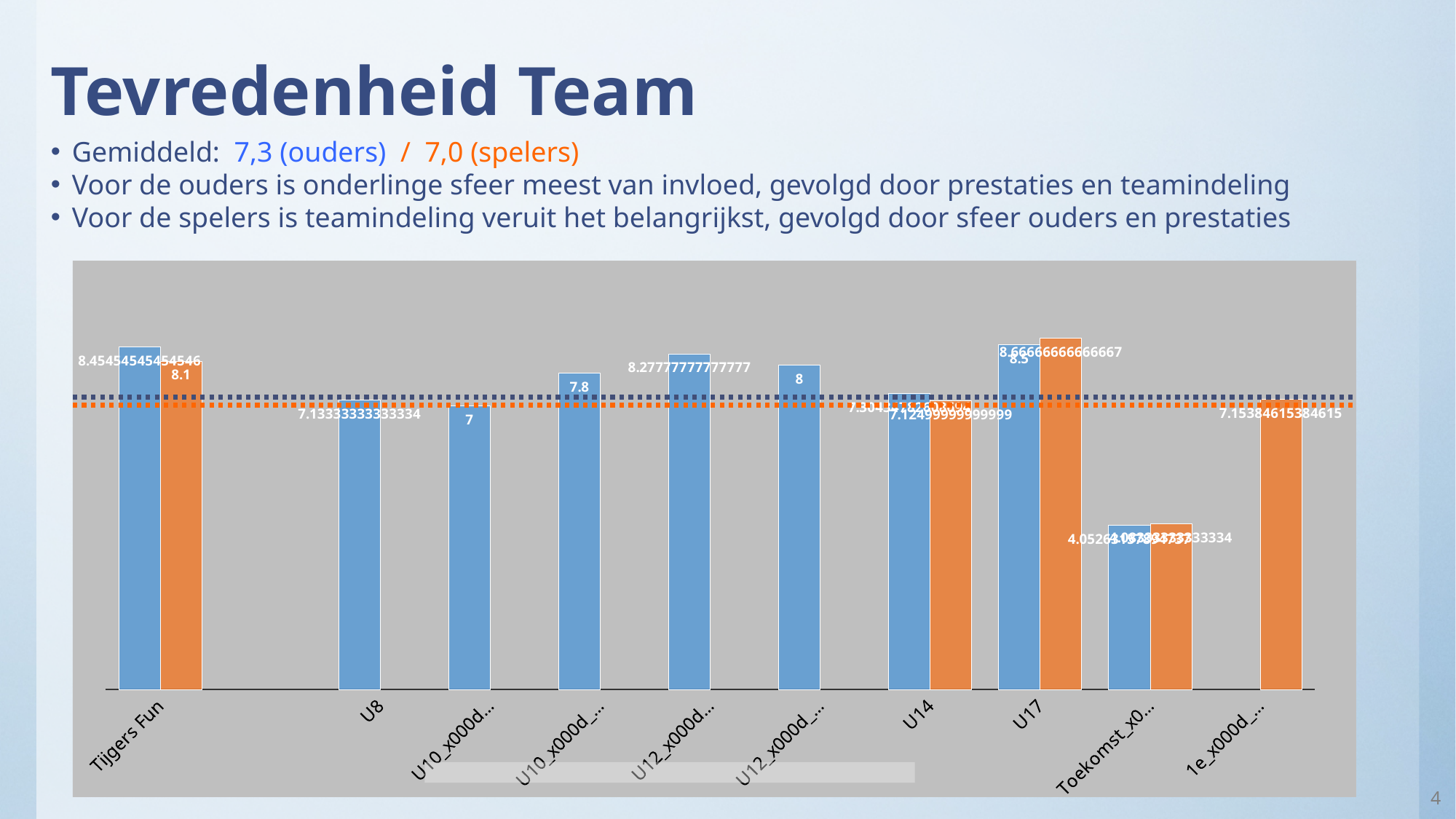
What is the value of the orange bar for U17? 8.66666666666667 What is the value of the blue bar for U17? 8.5 Which category has the shortest bars in the chart? Toekomst What is the value of the blue bar for U8? 7.13333333333334 What is the value of the orange bar for Tijgers Fun? 8.1 How many categories are shown on the x axis of the chart? 10 Which category has the tallest bar in the chart? U17 What kind of chart is shown on the slide? bar chart What is the value of the blue bar for Tijgers Fun? 8.45454545454546 Which blue bar is taller, U14 or U17? U17 What is the value of the orange bar for the last category (1e_x000d_...)? 7.15384615384615 For Tijgers Fun, which bar is taller, the blue one or the orange one? blue